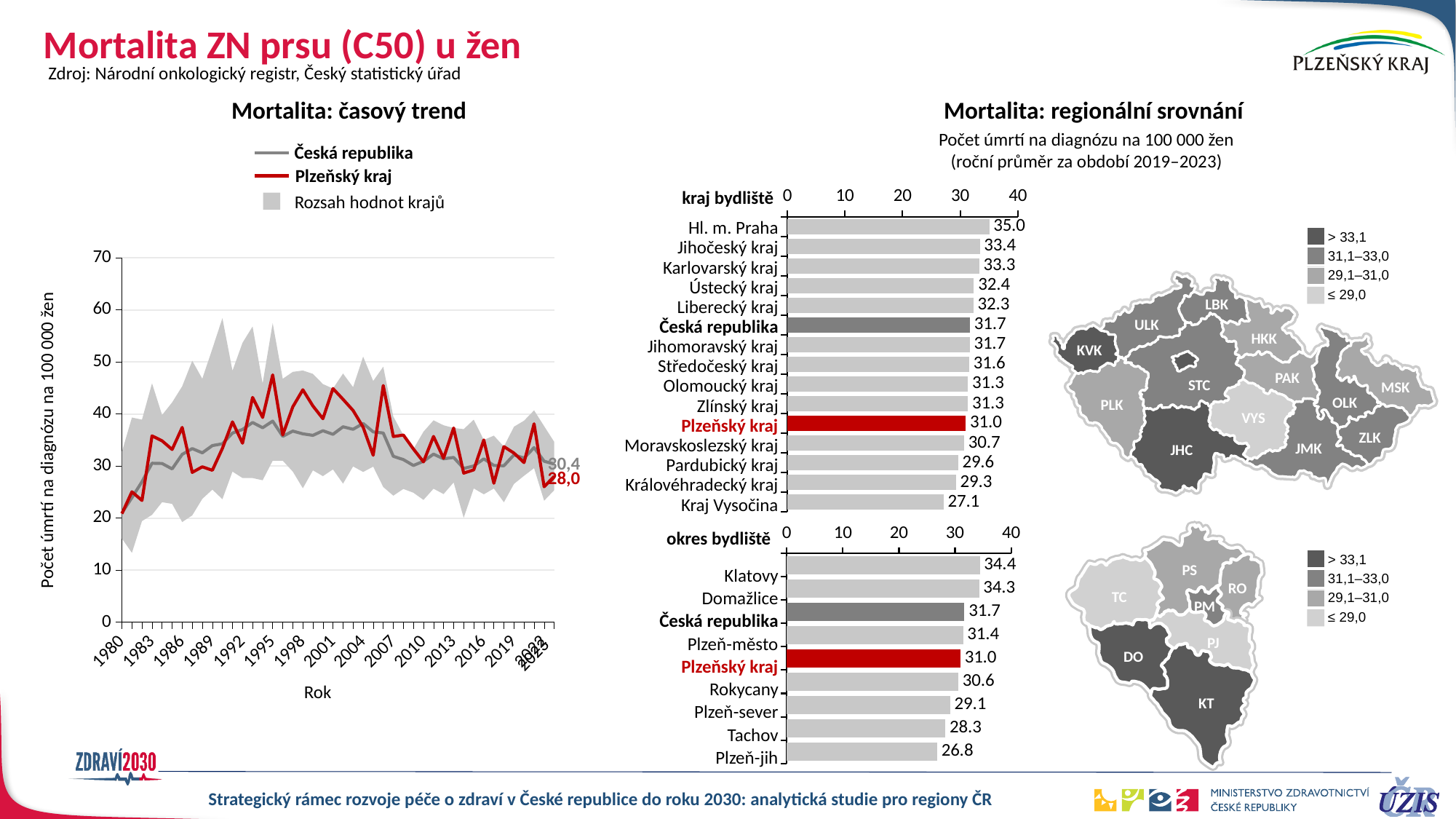
In the 'kraj bydliště' bar chart, how many bars are shown? 15 How many entries does the legend of the 'Mortalita: časový trend' chart list? 3 In the 'kraj bydliště' bar chart, which region has the lowest value? Kraj Vysočina In the 'okres bydliště' bar chart, what is the value for Tachov? 28.3 In the 'Mortalita: časový trend' line chart, what is the value labelled for Plzeňský kraj at the end of the series? 28,0 In the 'kraj bydliště' bar chart, what is the value for Plzeňský kraj? 31.0 In the 'okres bydliště' bar chart, which is larger, Rokycany or Plzeň-sever? Rokycany In the 'okres bydliště' bar chart, which district has the highest value? Klatovy In the 'okres bydliště' bar chart, which district has the lowest value? Plzeň-jih In the 'Mortalita: časový trend' line chart, what is the value labelled for Česká republika at the end of the series? 30,4 In the 'kraj bydliště' bar chart, what is the difference between Hl. m. Praha and Kraj Vysočina? 7.9 In the 'kraj bydliště' bar chart, which region has the highest value? Hl. m. Praha